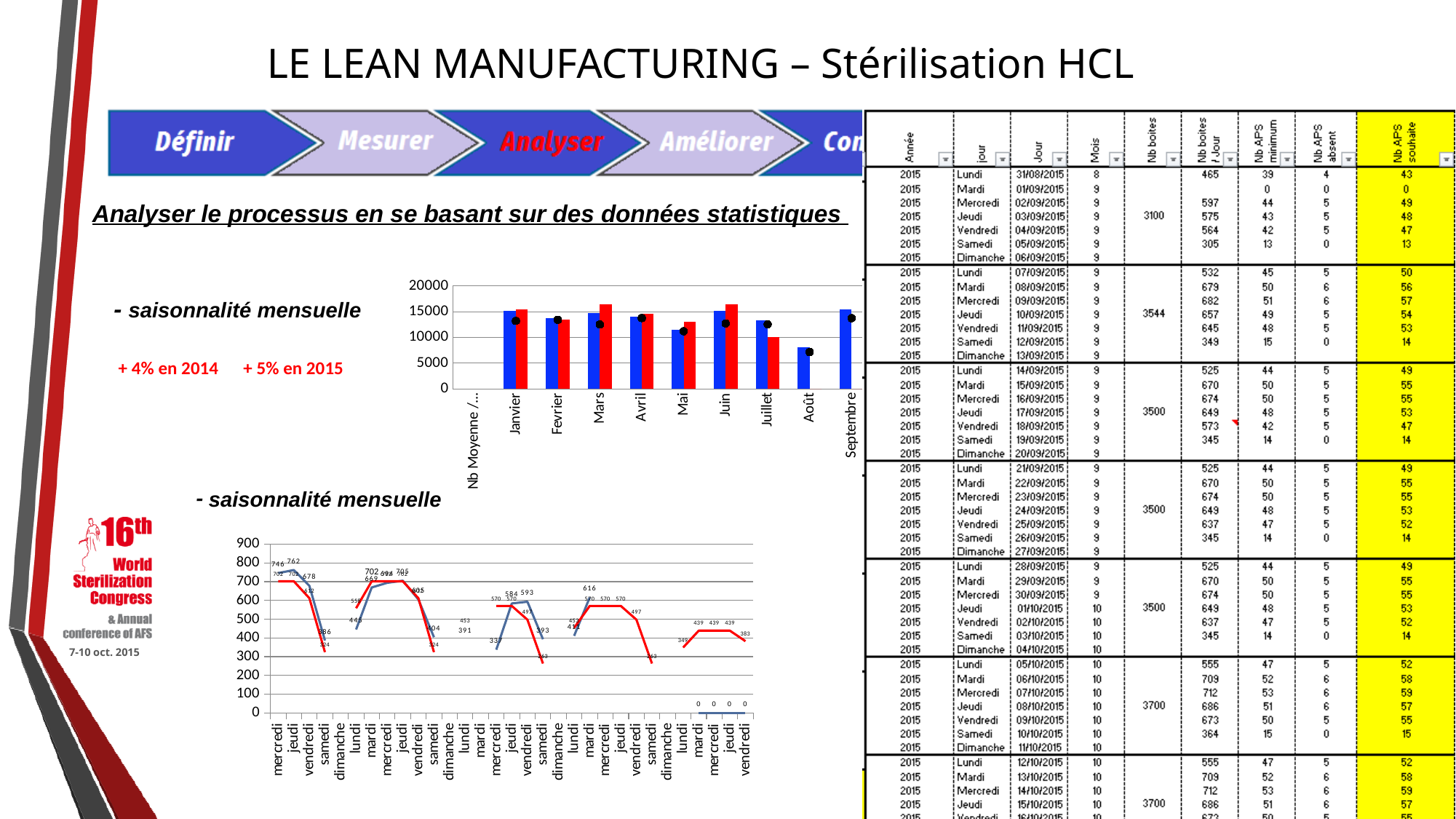
In the upper bar chart, which is larger: the red bar for Mars or the red bar for Juillet? Mars In the upper bar chart, which is larger: the blue bar for Janvier or the blue bar for Août? Janvier In the upper bar chart, is the blue bar for Août greater or less than 10000? less In the lower line chart, what value is labelled on the last four points of the blue line (mardi to vendredi at the far right)? 0 In the upper bar chart, how many months are labelled on the x axis (from Janvier to Septembre)? 9 What is the highest value shown on the y axis of the lower line chart? 900 In the upper bar chart, which month has the lowest blue bar? Août What kind of chart is the upper chart on the slide (the one with months on the x axis)? combination bar and line chart (bars with dot markers) What kind of chart is the lower chart on the slide (the one with weekdays on the x axis)? line chart In the upper bar chart, is the red bar for Mars greater or less than 15000? greater In the upper bar chart, is the blue bar for Mai greater or less than 10000? greater What is the highest value shown on the y axis of the upper bar chart? 20000